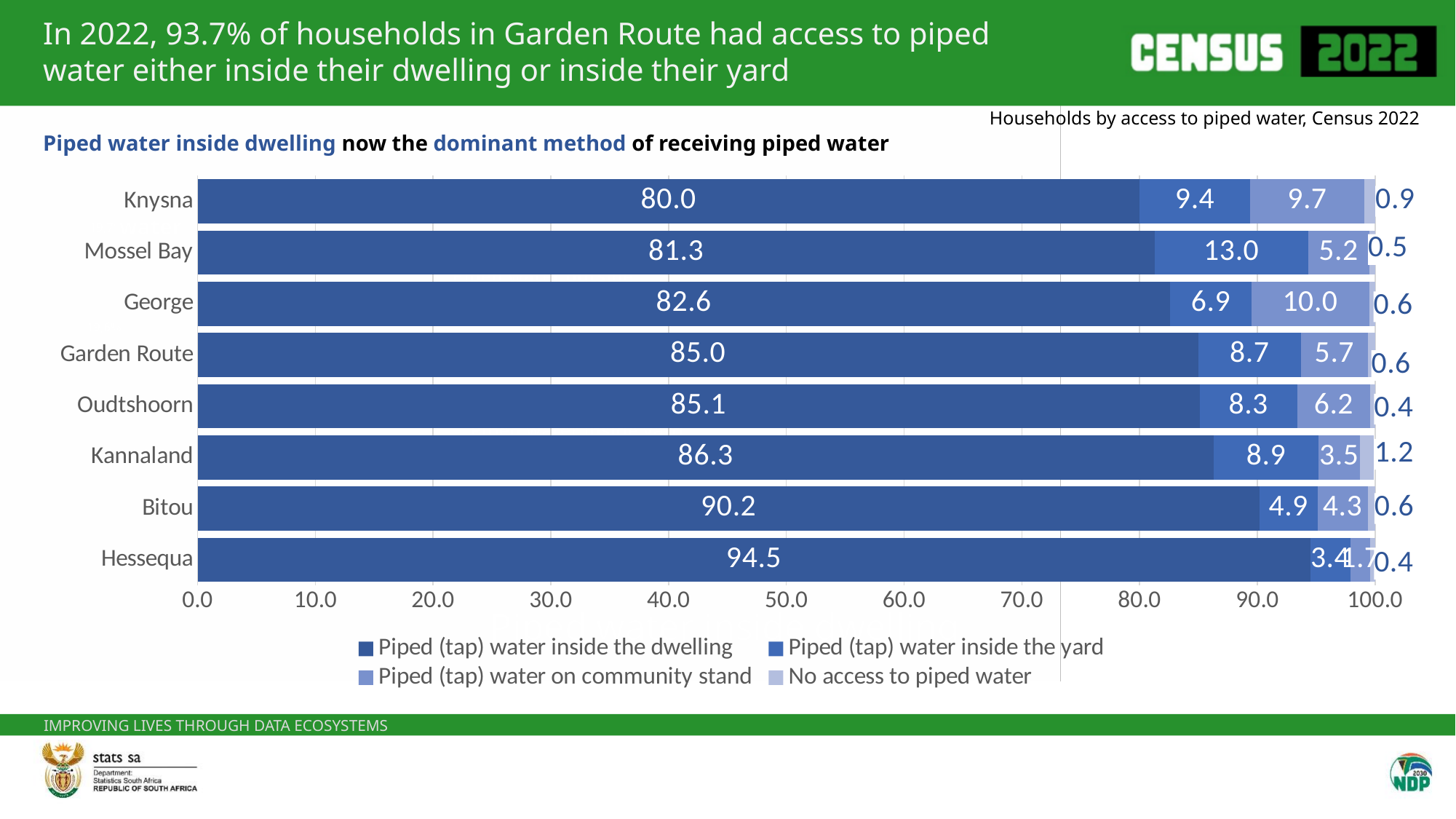
What is the value for piped (tap) water inside the dwelling for Garden Route? 85.0 Which municipality has the lowest share of households with piped (tap) water inside the dwelling? Knysna What type of chart is shown on the slide? Stacked bar chart What is the value for piped (tap) water on community stand for George? 10.0 What percentage of households in Knysna have piped (tap) water inside the dwelling? 80.0 Which municipality has the highest share of households with piped (tap) water inside the dwelling? Hessequa What is the difference between Bitou and Knysna in the share of households with piped (tap) water inside the dwelling? 10.2 Which has a larger share of households with piped (tap) water inside the yard, Mossel Bay or George? Mossel Bay What is the value for piped (tap) water inside the yard for Mossel Bay? 13.0 How many series does the legend list? 4 Which municipality has the highest value for no access to piped water? Kannaland How many municipalities/areas are shown on the chart? 8